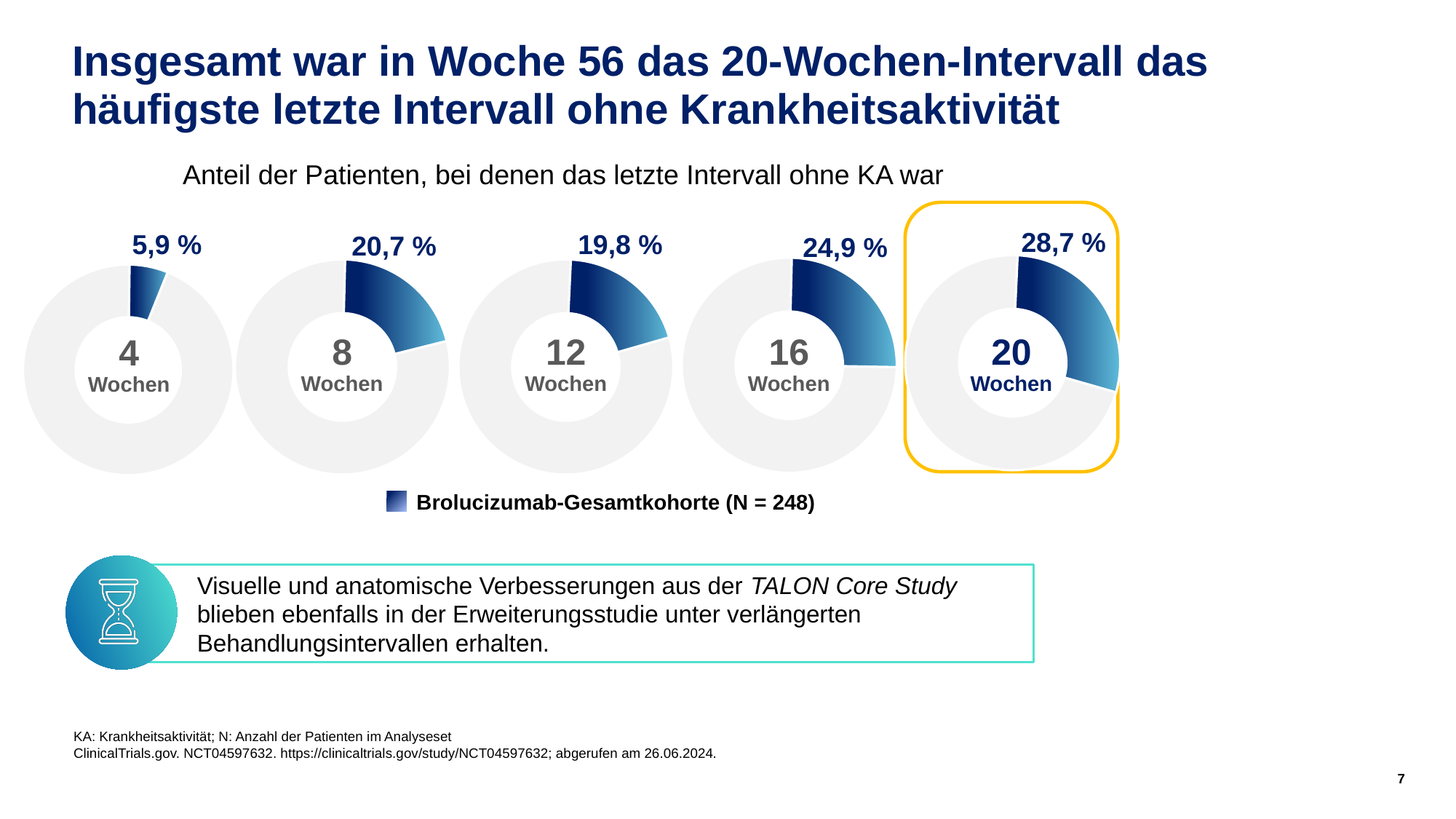
What kind of chart is used to show the shares on this slide? Donut (pie) chart What is the difference in percentage points between the 20 Wochen and 16 Wochen shares? 3,8 What share is shown in the donut chart for 20 Wochen? 28,7 % What cohort does the legend name for the charts? Brolucizumab-Gesamtkohorte (N = 248) What share is shown in the donut chart for 4 Wochen? 5,9 % Which interval has the lowest share of patients whose last interval was without KA? 4 Wochen What share is shown in the donut chart for 16 Wochen? 24,9 % Which interval has the highest share of patients whose last interval was without KA? 20 Wochen What is the difference in percentage points between the 8 Wochen and 12 Wochen shares? 0,9 Which has the larger share, 8 Wochen or 12 Wochen? 8 Wochen How many donut charts are shown on the slide? 5 What share is shown in the donut chart for 12 Wochen? 19,8 %